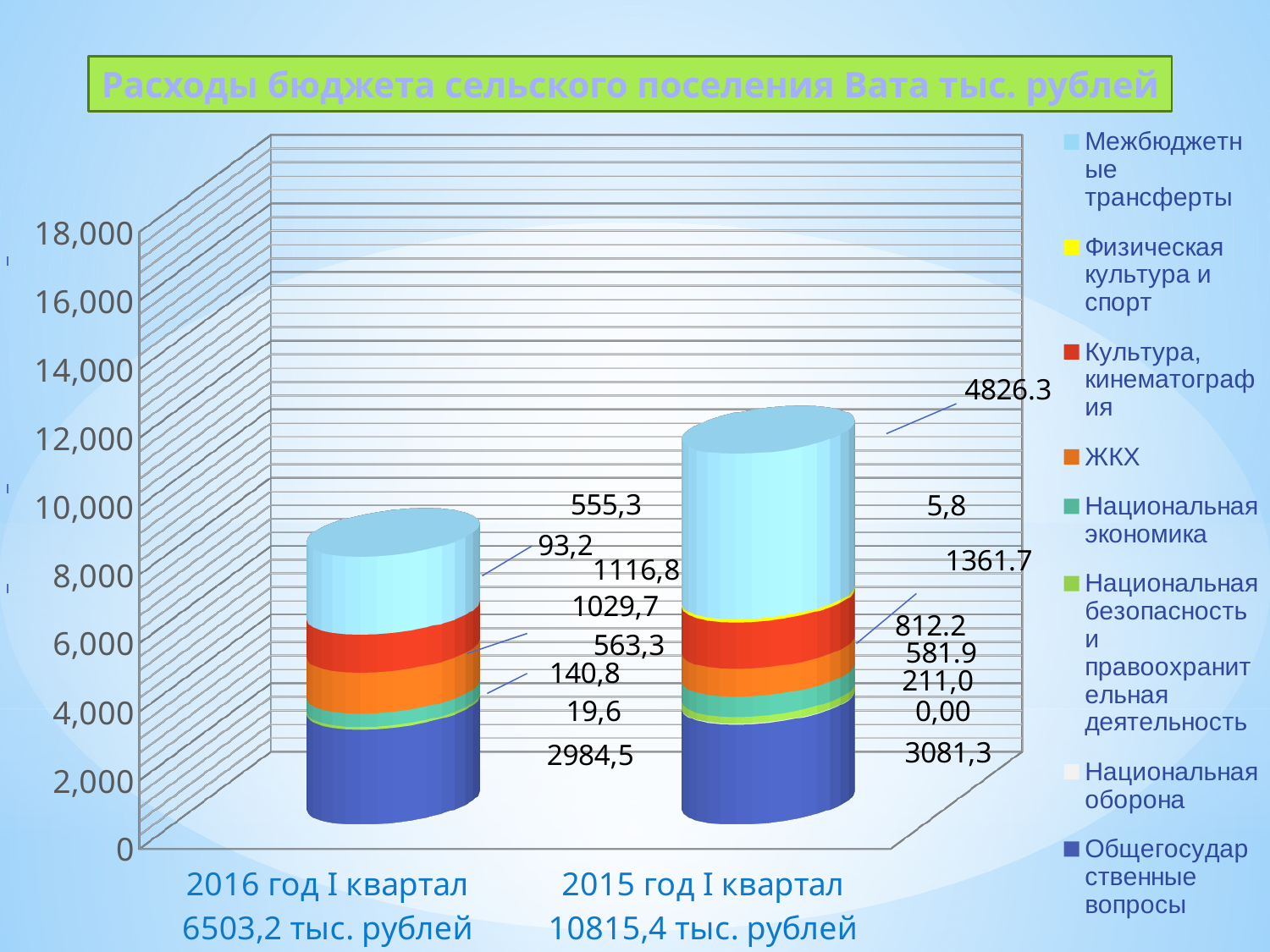
What is the total budget expenditure shown for 2016 год I квартал? 6503,2 тыс. рублей How many series does the legend list? 8 What is the title of the chart? Расходы бюджета сельского поселения Вата тыс. рублей What type of chart is shown on the slide? Stacked bar chart What is the value of Межбюджетные трансферты for 2015 год I квартал? 4826.3 What is the value of Общегосударственные вопросы for 2016 год I квартал? 2984,5 How many bars (categories) are plotted on the chart? 2 What is the total budget expenditure shown for 2015 год I квартал? 10815,4 тыс. рублей Which quarter has the larger total expenditure, 2016 год I квартал or 2015 год I квартал? 2015 год I квартал Which series is the largest segment in the 2015 год I квартал bar? Межбюджетные трансферты What is the difference between the total expenditure for 2015 год I квартал and 2016 год I квартал? 4312,2 тыс. рублей What is the value of Общегосударственные вопросы for 2015 год I квартал? 3081,3